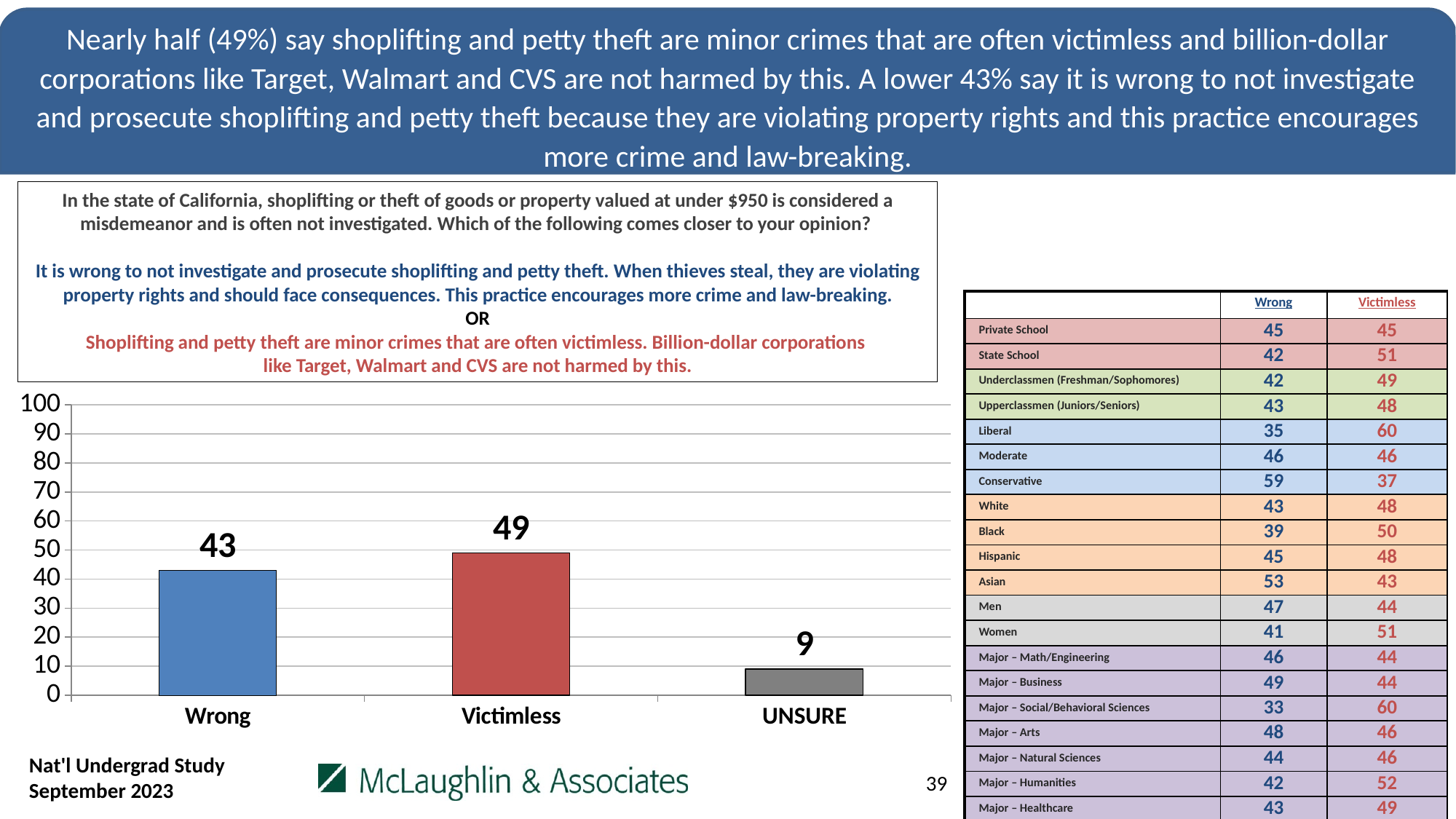
What is the difference between the Victimless and Wrong values in the bar chart? 6 What is the value for Wrong in the bar chart? 43 What kind of chart is shown on the slide? bar chart What is the value for UNSURE in the bar chart? 9 Which category has the highest value in the bar chart? Victimless Is the value for Wrong in the bar chart greater or less than 50? less What is the value for Victimless in the bar chart? 49 What colour is the Victimless bar in the bar chart? red How many categories are shown in the bar chart? 3 What is the maximum value shown on the vertical axis of the bar chart? 100 Which is larger in the bar chart, Wrong or Victimless? Victimless Which category has the lowest value in the bar chart? UNSURE